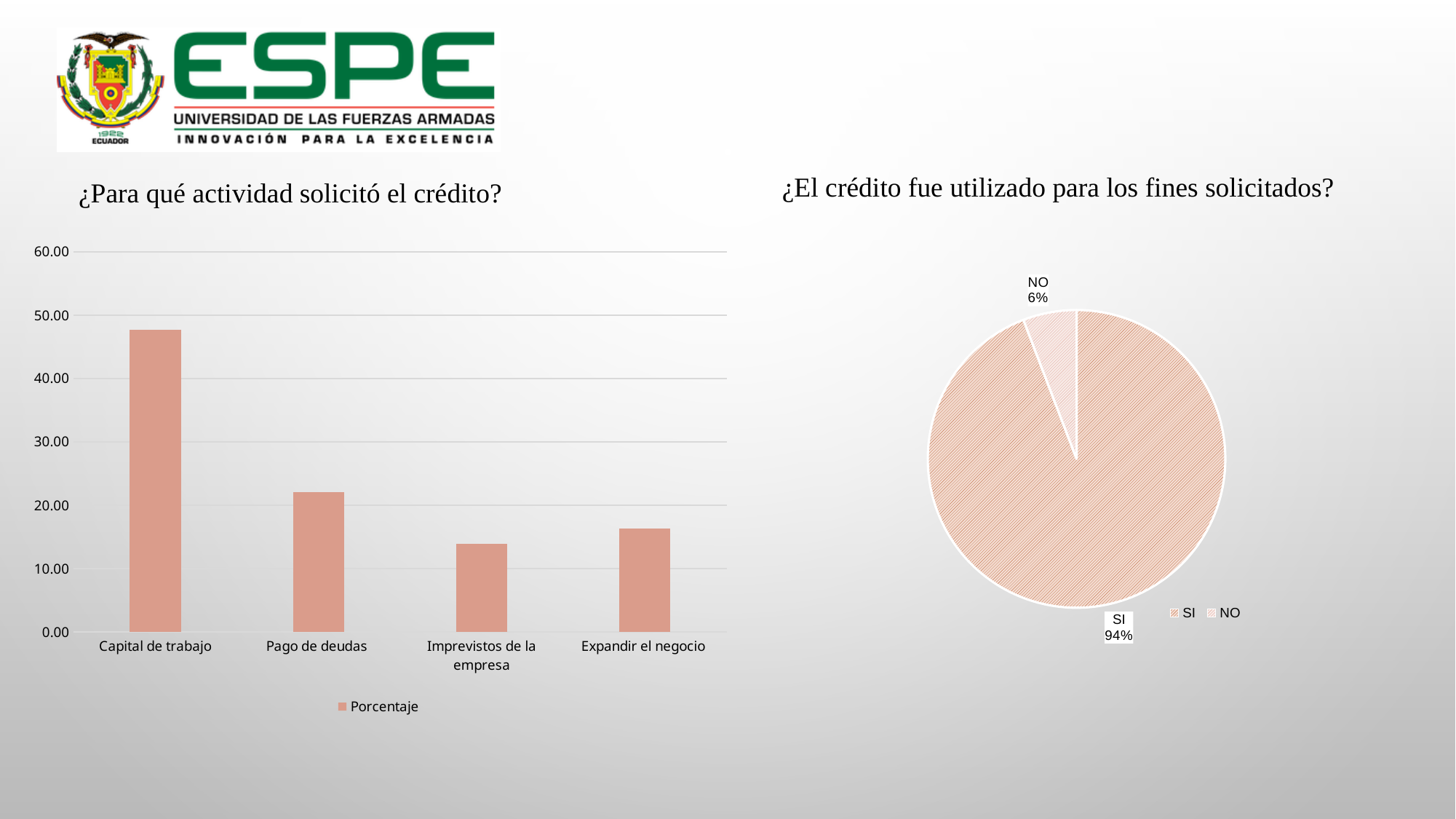
On the bar chart titled '¿Para qué actividad solicitó el crédito?', what series name does the legend show? Porcentaje What kind of chart is the one on the left of the slide? bar chart On the bar chart titled '¿Para qué actividad solicitó el crédito?', is the value for Capital de trabajo greater or less than 40.00? greater On the bar chart titled '¿Para qué actividad solicitó el crédito?', how many categories are shown? 4 On the bar chart titled '¿Para qué actividad solicitó el crédito?', which is larger: Pago de deudas or Expandir el negocio? Pago de deudas On the bar chart titled '¿Para qué actividad solicitó el crédito?', which category has the lowest value? Imprevistos de la empresa On the pie chart titled '¿El crédito fue utilizado para los fines solicitados?', what share does SI have? 94% On the bar chart titled '¿Para qué actividad solicitó el crédito?', which category has the highest value? Capital de trabajo On the bar chart titled '¿Para qué actividad solicitó el crédito?', is the value for Expandir el negocio greater or less than 20.00? less On the pie chart titled '¿El crédito fue utilizado para los fines solicitados?', how many slices are there? 2 On the bar chart titled '¿Para qué actividad solicitó el crédito?', is the value for Pago de deudas greater or less than 30.00? less On the pie chart titled '¿El crédito fue utilizado para los fines solicitados?', what share does NO have? 6%